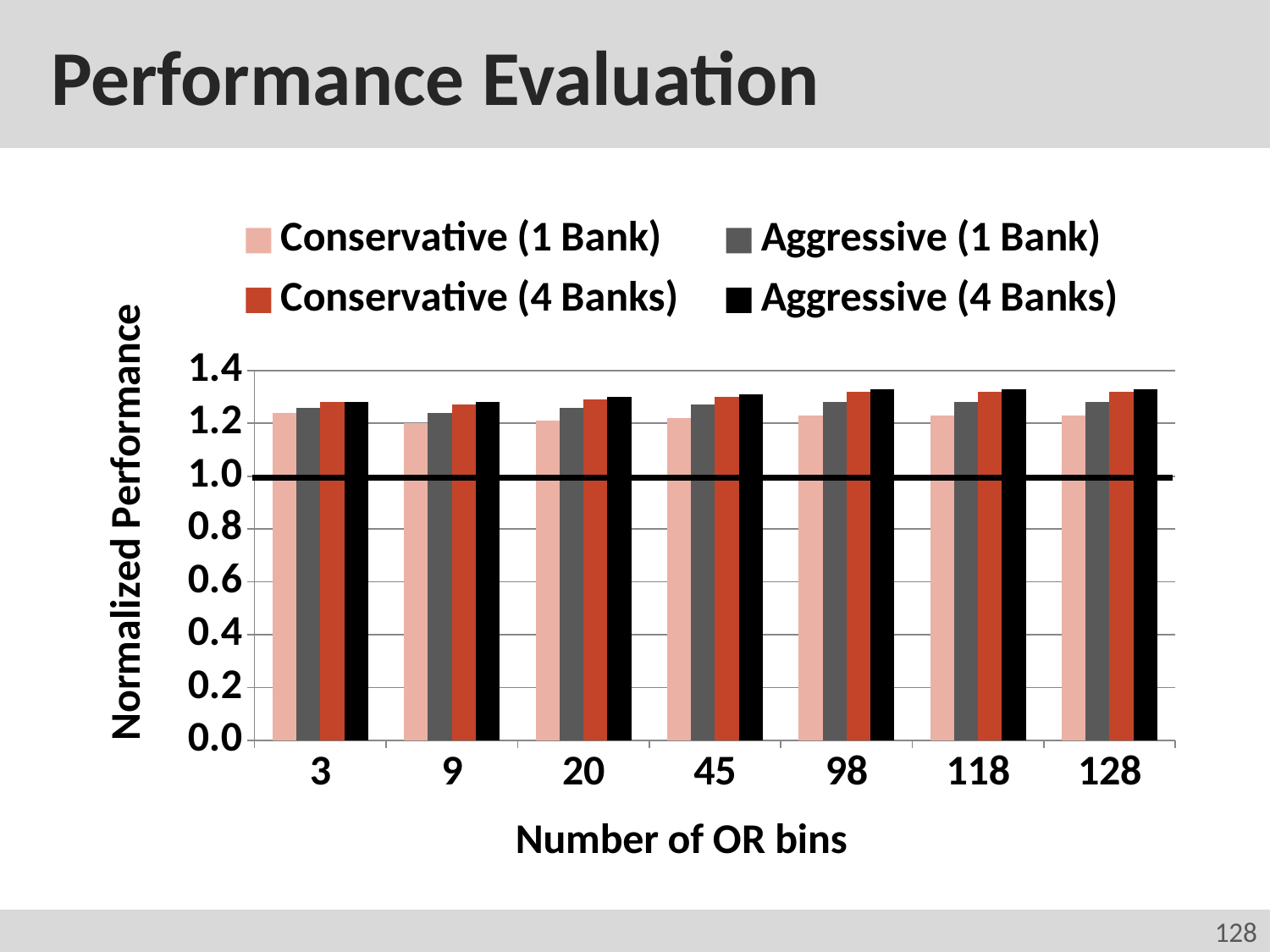
At 98 OR bins, which is larger: Conservative (1 Bank) or Aggressive (4 Banks)? Aggressive (4 Banks) What is the label of the x axis? Number of OR bins Is the value for Conservative (4 Banks) at 45 OR bins greater or less than 1.0? greater At 128 OR bins, which is larger: Conservative (1 Bank) or Aggressive (4 Banks)? Aggressive (4 Banks) What is the label of the y axis? Normalized Performance Is the value for Aggressive (4 Banks) at 128 OR bins greater or less than 1.2? greater What kind of chart is shown on the slide? Bar chart Is the value for Aggressive (4 Banks) at 128 OR bins greater or less than 1.4? less How many categories (numbers of OR bins) are shown on the x axis? 7 How many series does the legend list? 4